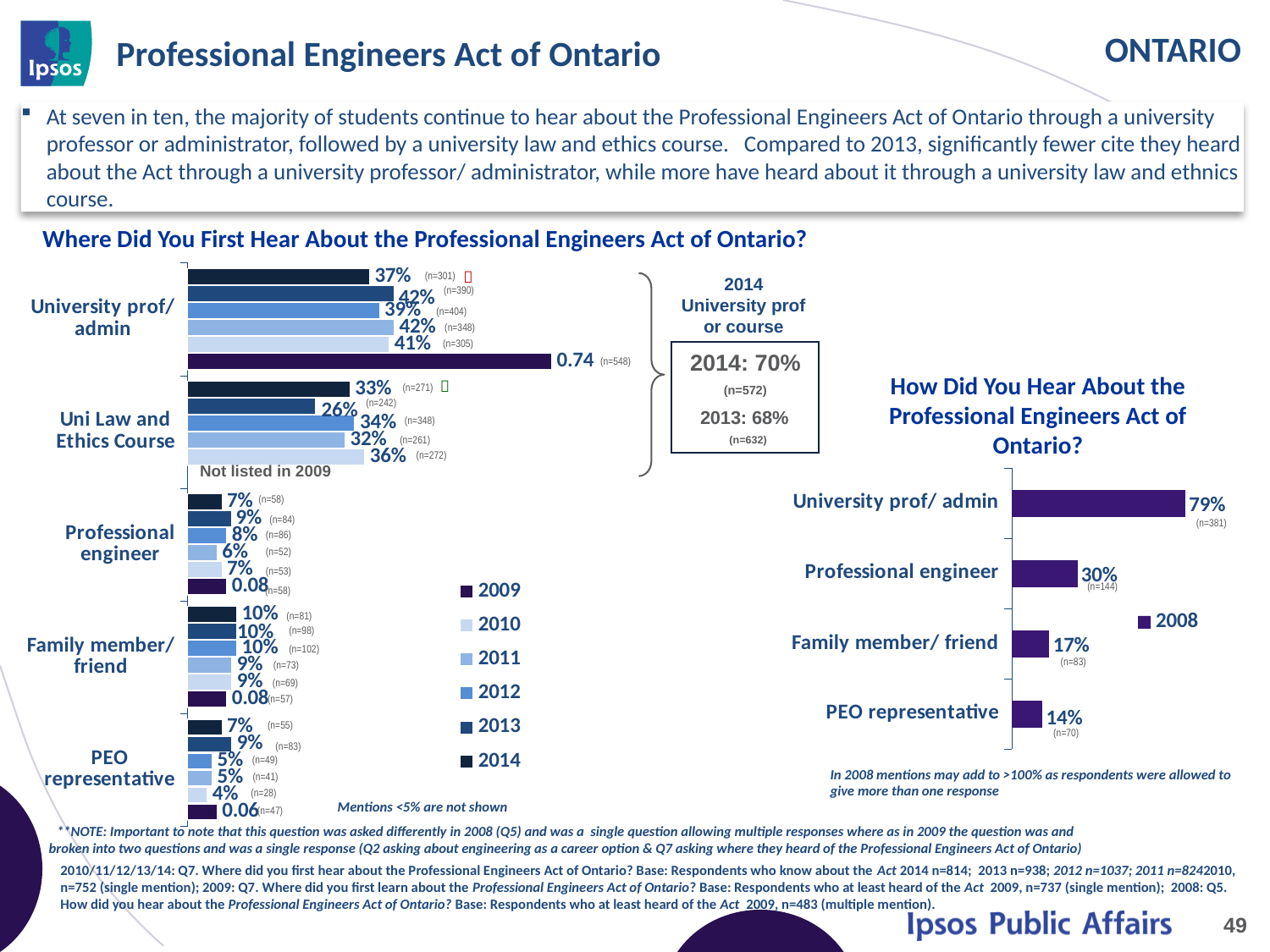
How many categories are shown in the 'Where Did You First Hear About the Professional Engineers Act of Ontario?' chart? 5 In the 'How Did You Hear About the Professional Engineers Act of Ontario?' chart, which is larger: Family member/ friend or PEO representative? Family member/ friend In the 'How Did You Hear About the Professional Engineers Act of Ontario?' chart, which category has the lowest value? PEO representative In the 'How Did You Hear About the Professional Engineers Act of Ontario?' chart, what is the value for PEO representative? 14% How many categories are shown in the 'How Did You Hear About the Professional Engineers Act of Ontario?' chart? 4 Which year does the legend of the 'How Did You Hear About the Professional Engineers Act of Ontario?' chart list? 2008 In the 'How Did You Hear About the Professional Engineers Act of Ontario?' chart, what is the value for University prof/ admin? 79% How many series does the legend of the 'Where Did You First Hear About the Professional Engineers Act of Ontario?' chart list? 6 What kind of chart is the 'Where Did You First Hear About the Professional Engineers Act of Ontario?' chart? Bar chart In the 'How Did You Hear About the Professional Engineers Act of Ontario?' chart, which category has the highest value? University prof/ admin In the 'How Did You Hear About the Professional Engineers Act of Ontario?' chart, what is the value for Professional engineer? 30% In the 'How Did You Hear About the Professional Engineers Act of Ontario?' chart, what is the difference between University prof/ admin and Professional engineer? 49 percentage points